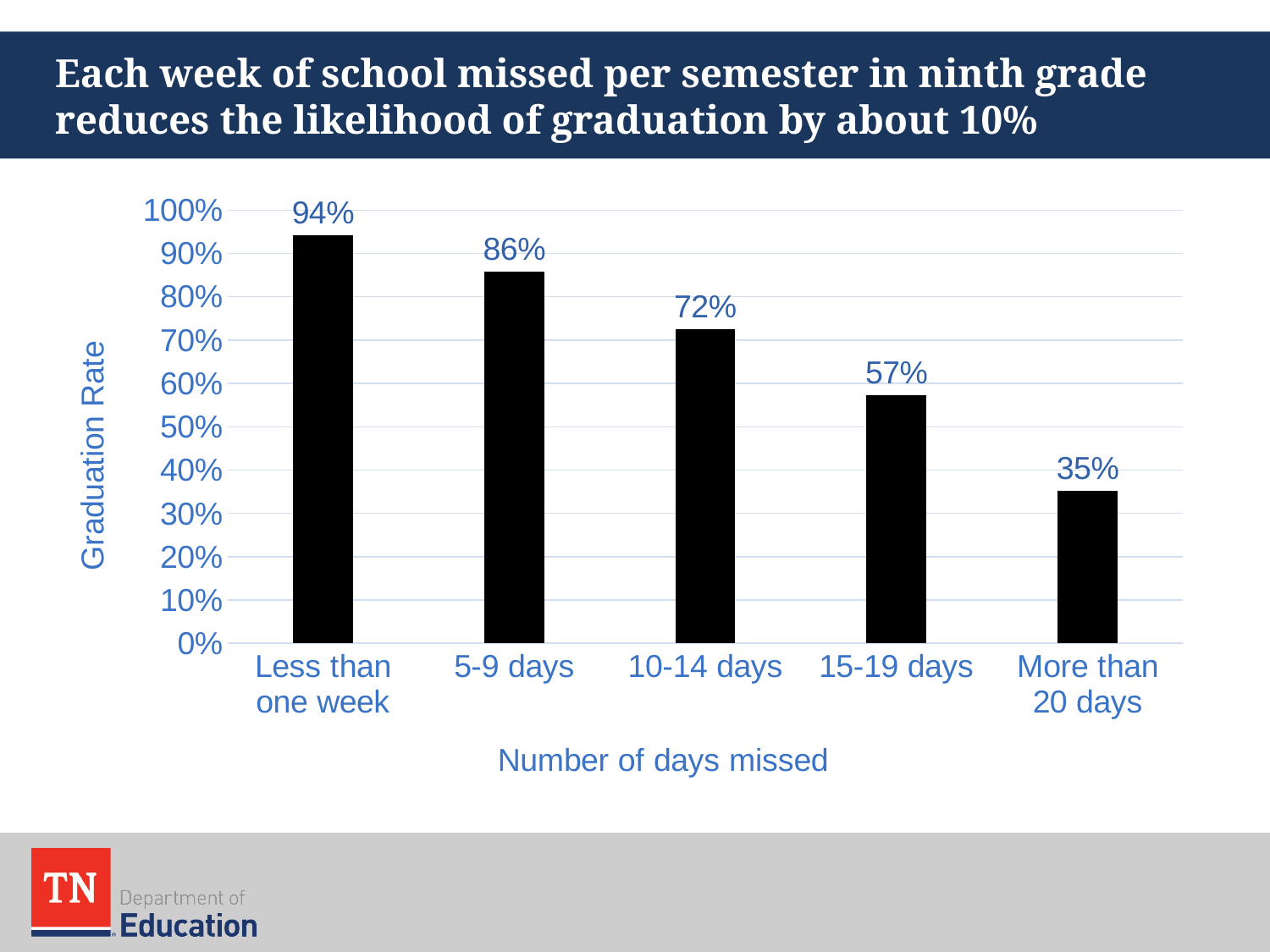
What is the graduation rate for students who missed 10-14 days? 72% What is the graduation rate for students who missed less than one week? 94% Does the graduation rate rise or fall as the number of days missed increases? Fall What is the difference in graduation rate between less than one week and more than 20 days? 59% Which has a higher graduation rate, 10-14 days or 15-19 days? 10-14 days Is the graduation rate for 15-19 days greater or less than 60%? less What kind of chart is shown on the slide? Bar chart How many categories of days missed are shown on the chart? 5 Which category has the highest graduation rate? Less than one week What is the graduation rate for students who missed more than 20 days? 35% Which category has the lowest graduation rate? More than 20 days What is the difference in graduation rate between 5-9 days and 15-19 days? 29%